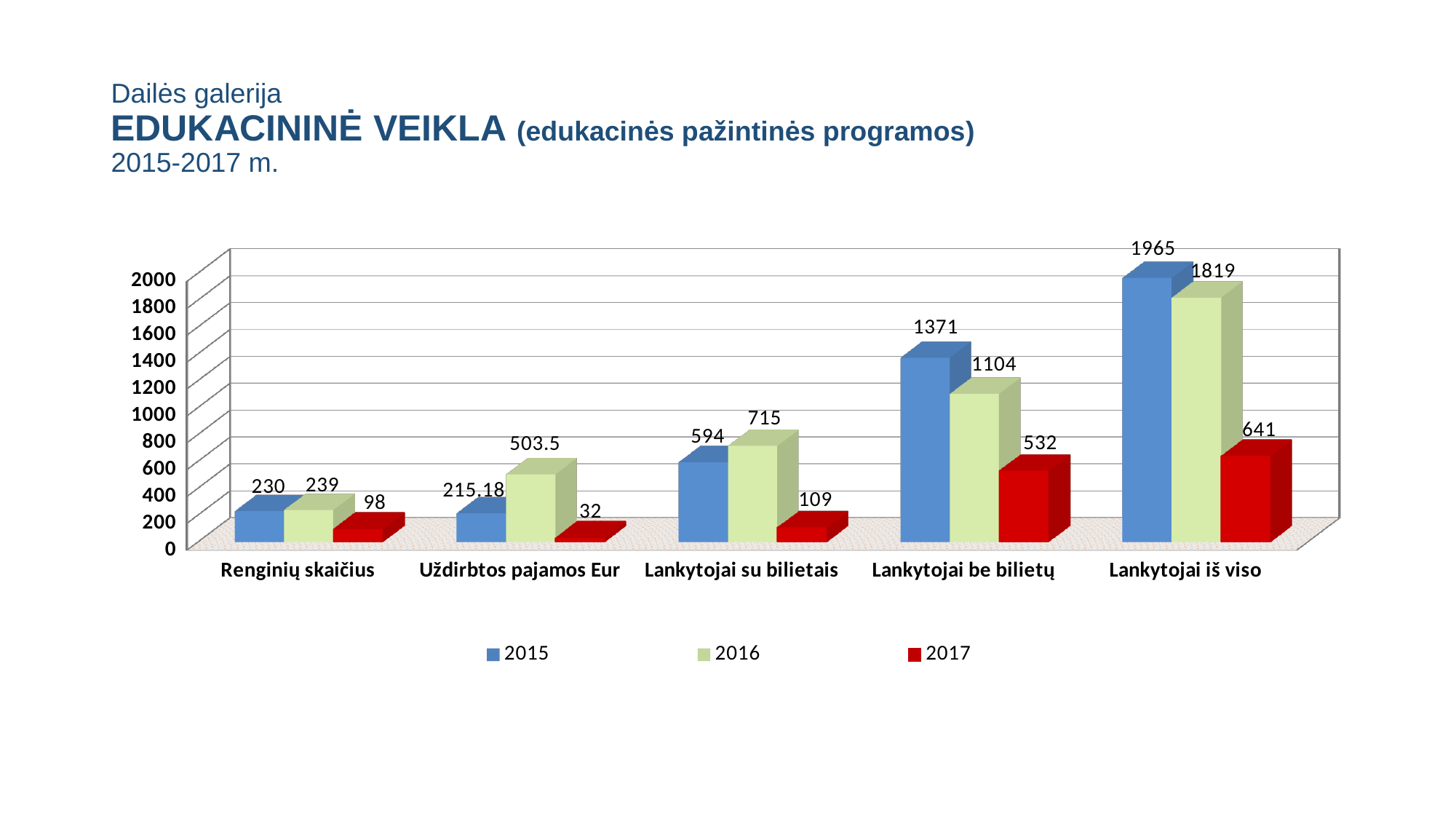
Which category has the lowest value for the 2017 series? Uždirbtos pajamos Eur Which category has the highest value for the 2017 series? Lankytojai iš viso Which colour represents the 2017 series in the legend? Red What is the value for 2015 in the Lankytojai iš viso category? 1965 Which is larger in the Lankytojai su bilietais category, the 2015 value or the 2016 value? 2016 How many categories are shown on the x axis? 5 What kind of chart is shown on the slide? Bar chart How many series does the legend list? 3 What is the value for 2017 in the Renginių skaičius category? 98 What is the difference between the 2015 and 2016 values in the Lankytojai be bilietų category? 267 What is the value for 2015 in the Uždirbtos pajamos Eur category? 215.18 What is the value for 2016 in the Uždirbtos pajamos Eur category? 503.5